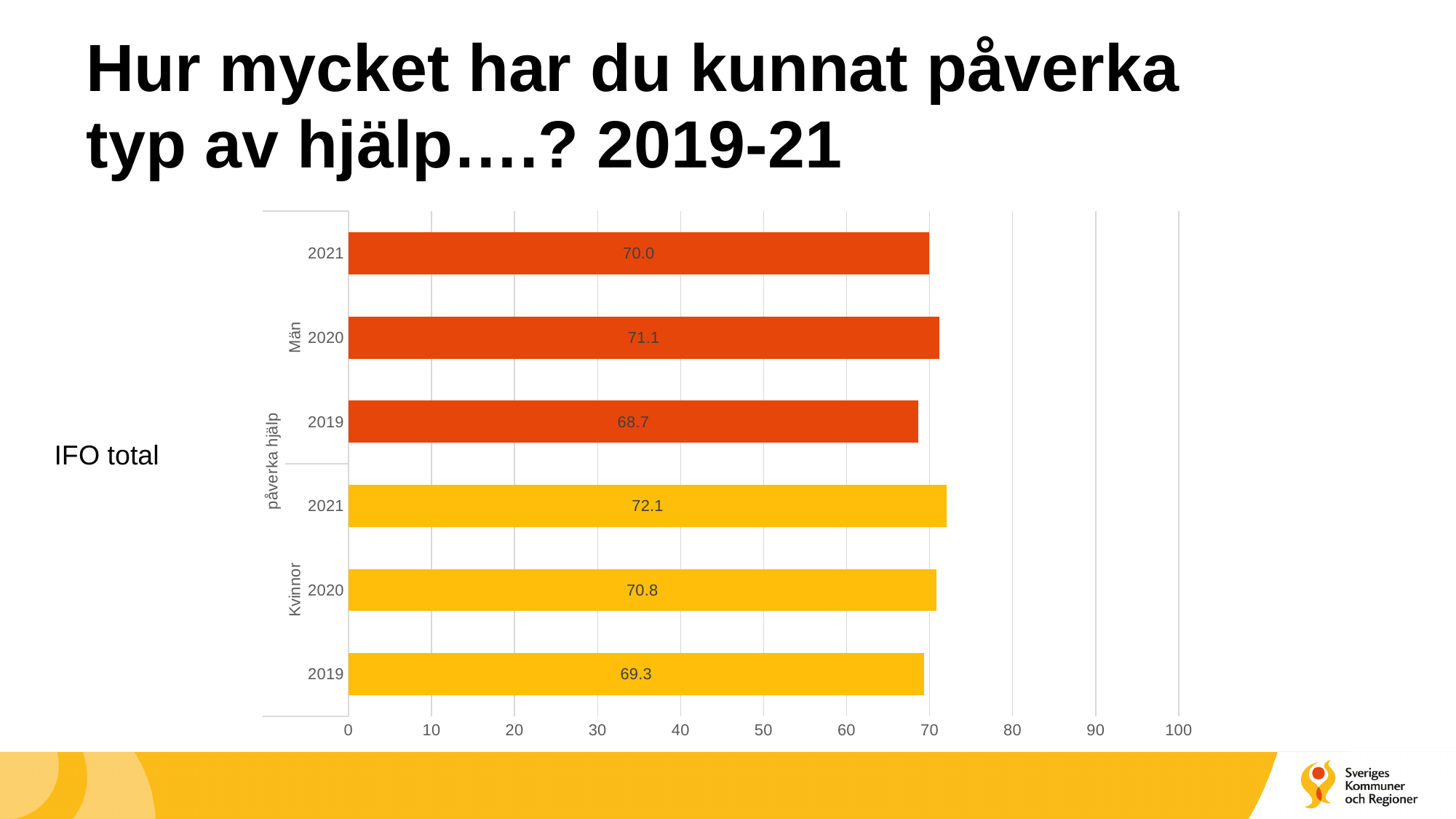
What is the difference between the Män 2020 value and the Män 2019 value? 2.4 Which bar has the highest value on the chart? Kvinnor 2021 How many bars are plotted on the chart? 6 What kind of chart is shown on the slide? bar chart Which is larger, the Män 2021 value or the Kvinnor 2021 value? Kvinnor 2021 What is the difference between the Kvinnor 2021 value and the Kvinnor 2019 value? 2.8 What is the value for Män in 2020? 71.1 Is the value for Män in 2019 greater or less than 70? less What is the value for Kvinnor in 2021? 72.1 Which bar has the lowest value on the chart? Män 2019 What is the value for Män in 2019? 68.7 What is the value for Kvinnor in 2019? 69.3